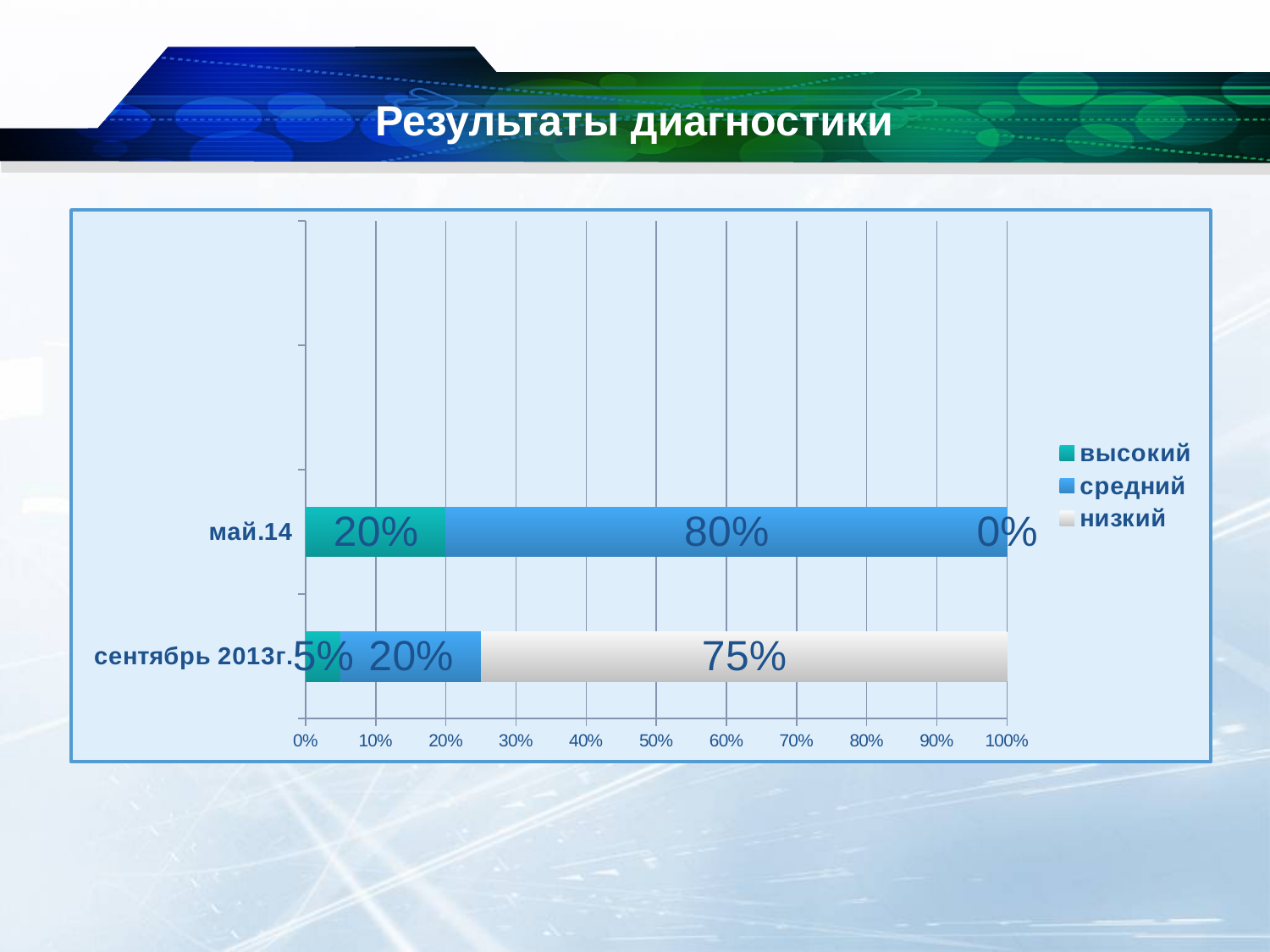
How many categories are shown on the vertical axis? 2 Which category has the higher 'низкий' value, май.14 or сентябрь 2013г.? сентябрь 2013г. What is the value of the 'высокий' series for сентябрь 2013г.? 5% What is the value of the 'низкий' series for май.14? 0% How many series does the legend list? 3 What is the value of the 'средний' series for май.14? 80% What is the title of the slide? Результаты диагностики What is the total of the stacked bar for май.14? 100% What kind of chart is shown on the slide? bar chart What is the difference between the 'средний' values for май.14 and сентябрь 2013г.? 60% What is the value of the 'высокий' series for май.14? 20% What is the value of the 'низкий' series for сентябрь 2013г.? 75%